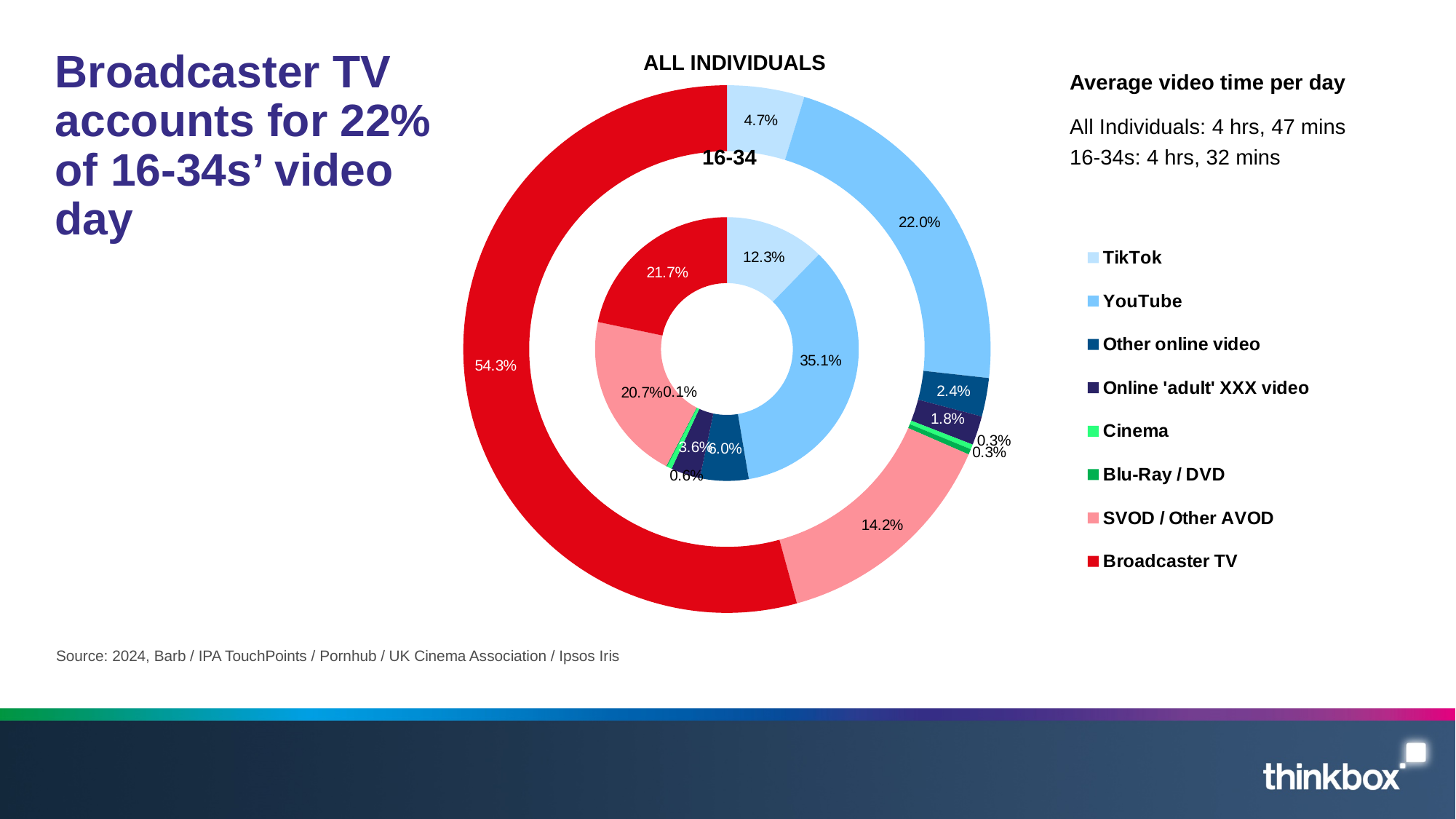
In the ALL INDIVIDUALS (outer) ring, what share does Broadcaster TV account for? 54.3% Which category has the largest share in the 16-34 (inner) ring? YouTube What type of chart is shown on the slide? Doughnut chart Which is larger in the 16-34 (inner) ring: the TikTok share or the Other online video share? TikTok In the ALL INDIVIDUALS (outer) ring, what share does SVOD / Other AVOD account for? 14.2% According to the text on the slide, what is the average video time per day for 16-34s? 4 hrs, 32 mins How many categories does the legend list? 8 What is the difference between the Broadcaster TV share for ALL INDIVIDUALS (54.3%) and for 16-34 (21.7%)? 32.6 percentage points In the 16-34 (inner) ring, what share does YouTube account for? 35.1% Which category has the largest share in the ALL INDIVIDUALS (outer) ring? Broadcaster TV In the 16-34 (inner) ring, what share does Broadcaster TV account for? 21.7% In the ALL INDIVIDUALS (outer) ring, what share does TikTok account for? 4.7%